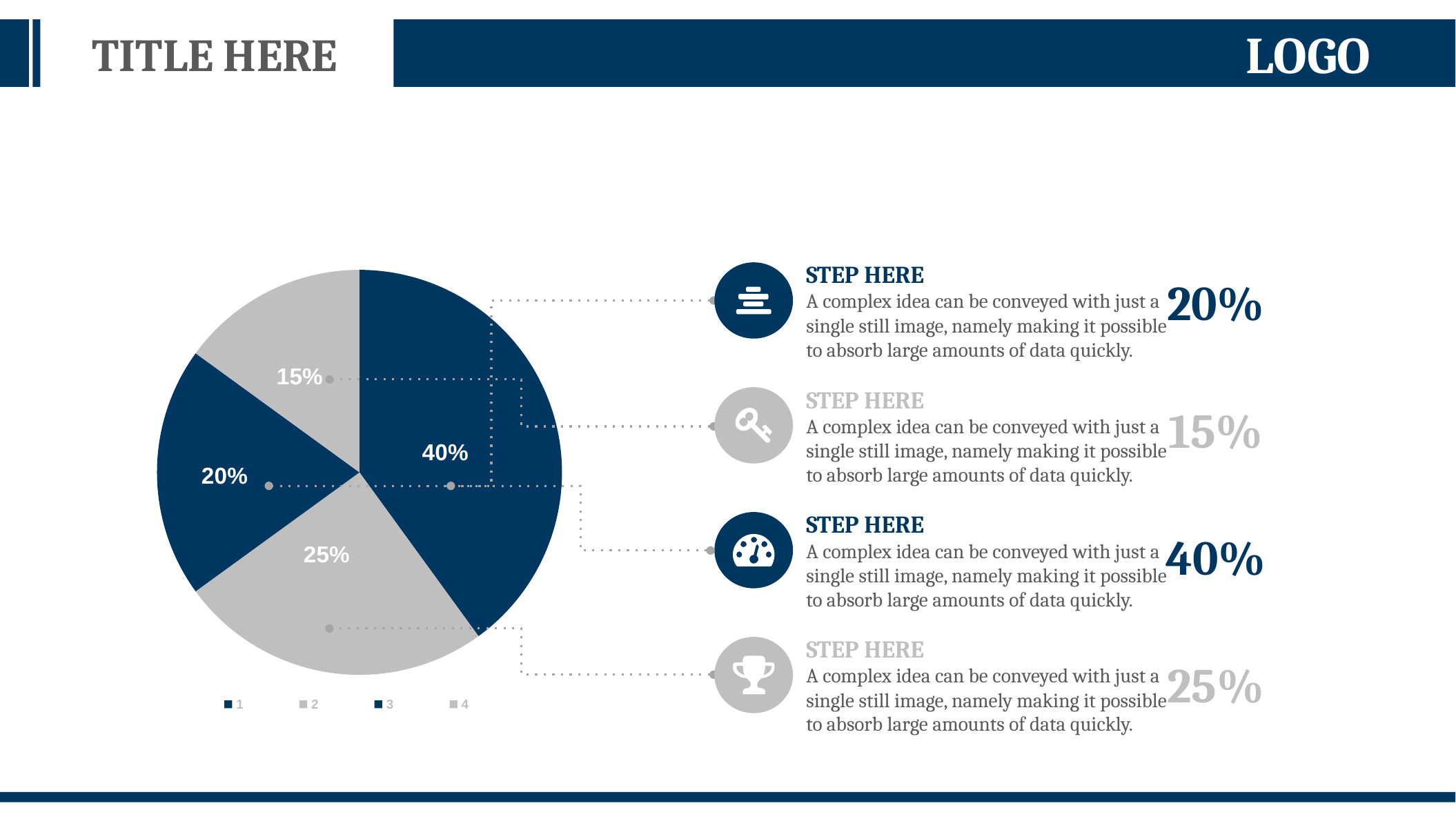
What kind of chart is shown on the slide? Pie chart What is the combined share of the two dark blue slices in the pie chart? 60% What is the value of the slice labelled 1 in the pie chart? 40% What is the difference between the largest and smallest slices in the pie chart? 25% What colour is the 25% slice in the pie chart? Gray Which slice is larger in the pie chart, the one labelled 2 or the one labelled 3? 2 What is the value of the largest slice in the pie chart? 40% How many slices does the pie chart have? 4 What is the value of the slice labelled 2 in the pie chart? 25% What is the value of the slice labelled 4 in the pie chart? 15% What is the value of the smallest slice in the pie chart? 15% How many entries does the legend of the pie chart list? 4